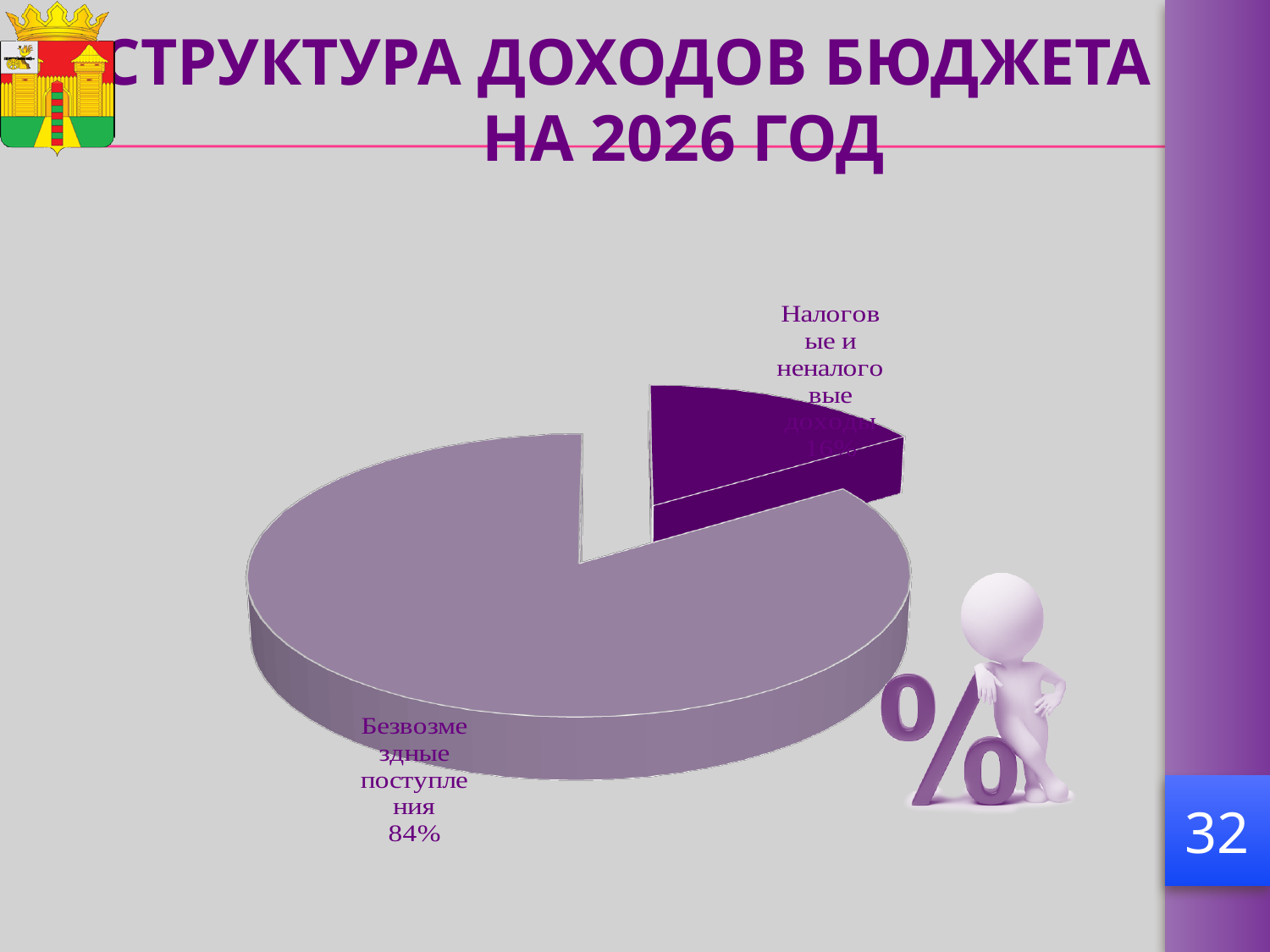
Which category has the largest slice of the pie? Безвозмездные поступления Which is larger: the slice for "Безвозмездные поступления" or the slice for "Налоговые и неналоговые доходы"? Безвозмездные поступления What is the title of the slide containing the chart? СТРУКТУРА ДОХОДОВ БЮДЖЕТА НА 2026 ГОД Which slice is drawn in the darker purple colour? Налоговые и неналоговые доходы What percentage is printed for the "Безвозмездные поступления" slice? 84% Which category has the smallest slice of the pie? Налоговые и неналоговые доходы What share of the pie does "Безвозмездные поступления" account for? 84% What kind of chart is shown on the slide? pie chart How many slices does the pie chart have? 2